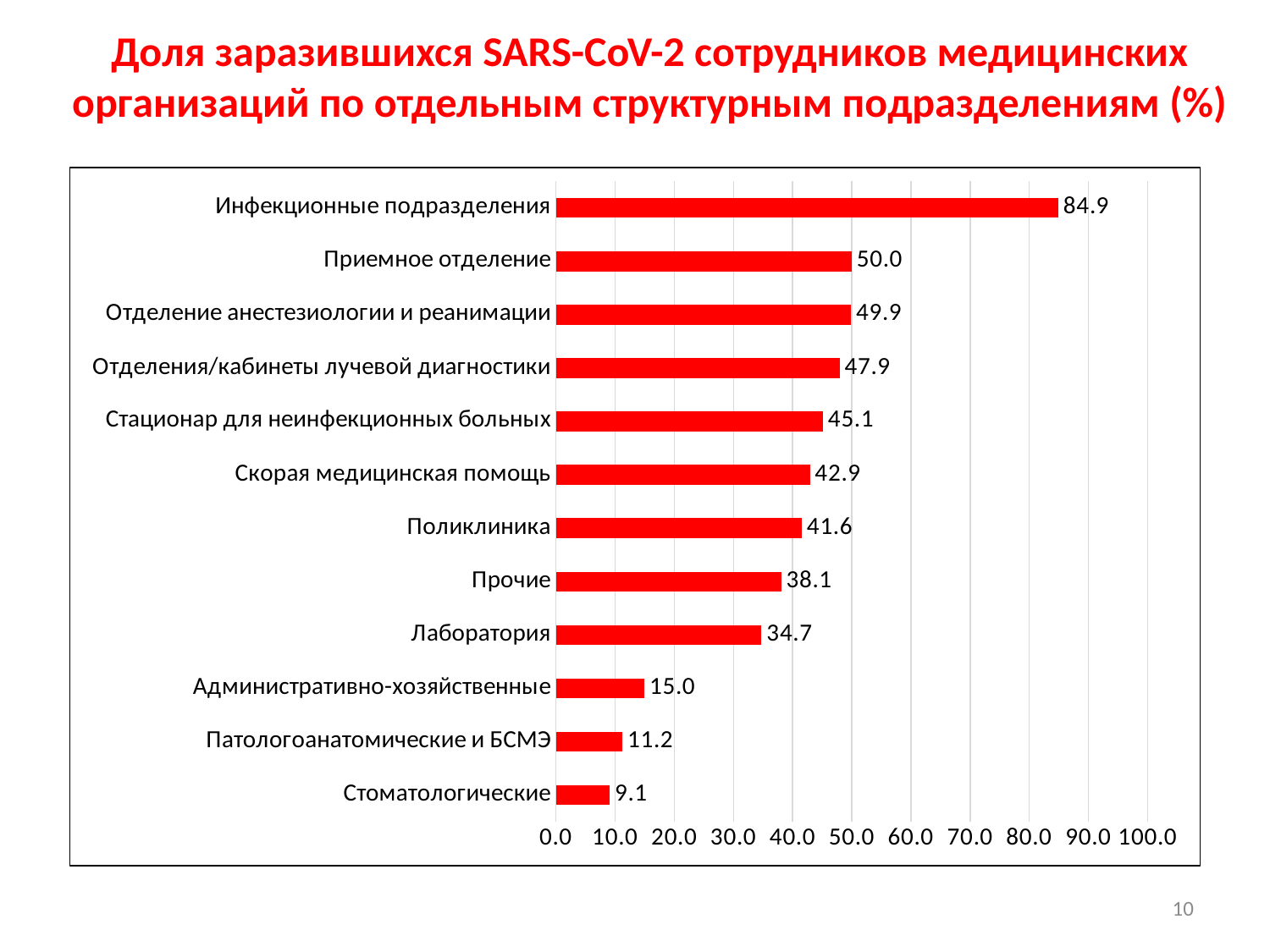
What is the value for Стоматологические? 9.1 What kind of chart is shown on the slide? bar chart Which category has the highest value? Инфекционные подразделения What is the value for Лаборатория? 34.7 Which is larger, the value for Скорая медицинская помощь or the value for Поликлиника? Скорая медицинская помощь What is the difference between the values for Инфекционные подразделения and Приемное отделение? 34.9 What colour are the bars in the chart? red What is the value for Инфекционные подразделения? 84.9 What is the difference between the values for Административно-хозяйственные and Патологоанатомические и БСМЭ? 3.8 Is the value for Прочие greater or less than 40.0? less How many categories are shown in the chart? 12 Which category has the lowest value? Стоматологические